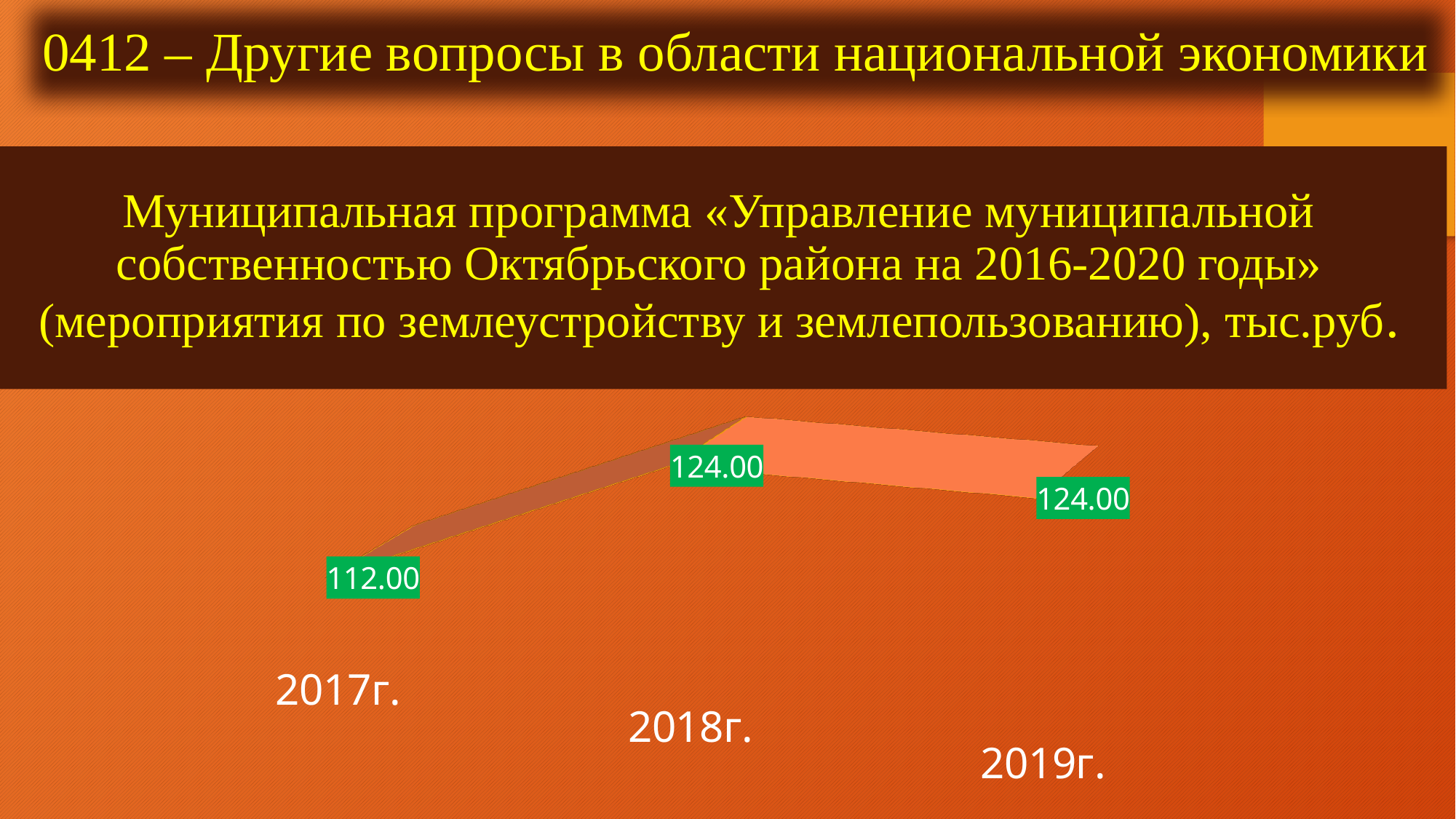
Do the values change from 2018г. to 2019г.? No, they stay at 124.00 What is the value for 2017г.? 112.00 What is the value for 2018г.? 124.00 Which is larger, the value for 2017г. or the value for 2018г.? 2018г. How many years are plotted on the chart? 3 What is the difference between the values for 2018г. and 2017г.? 12.00 In what units are the chart values given, according to the heading? тыс.руб. Are the values for 2018г. and 2019г. the same or different? the same What kind of chart is shown on the slide? 3D line chart Which year has the lowest value? 2017г. What is the value for 2019г.? 124.00 Do the values rise or fall from 2017г. to 2018г.? rise